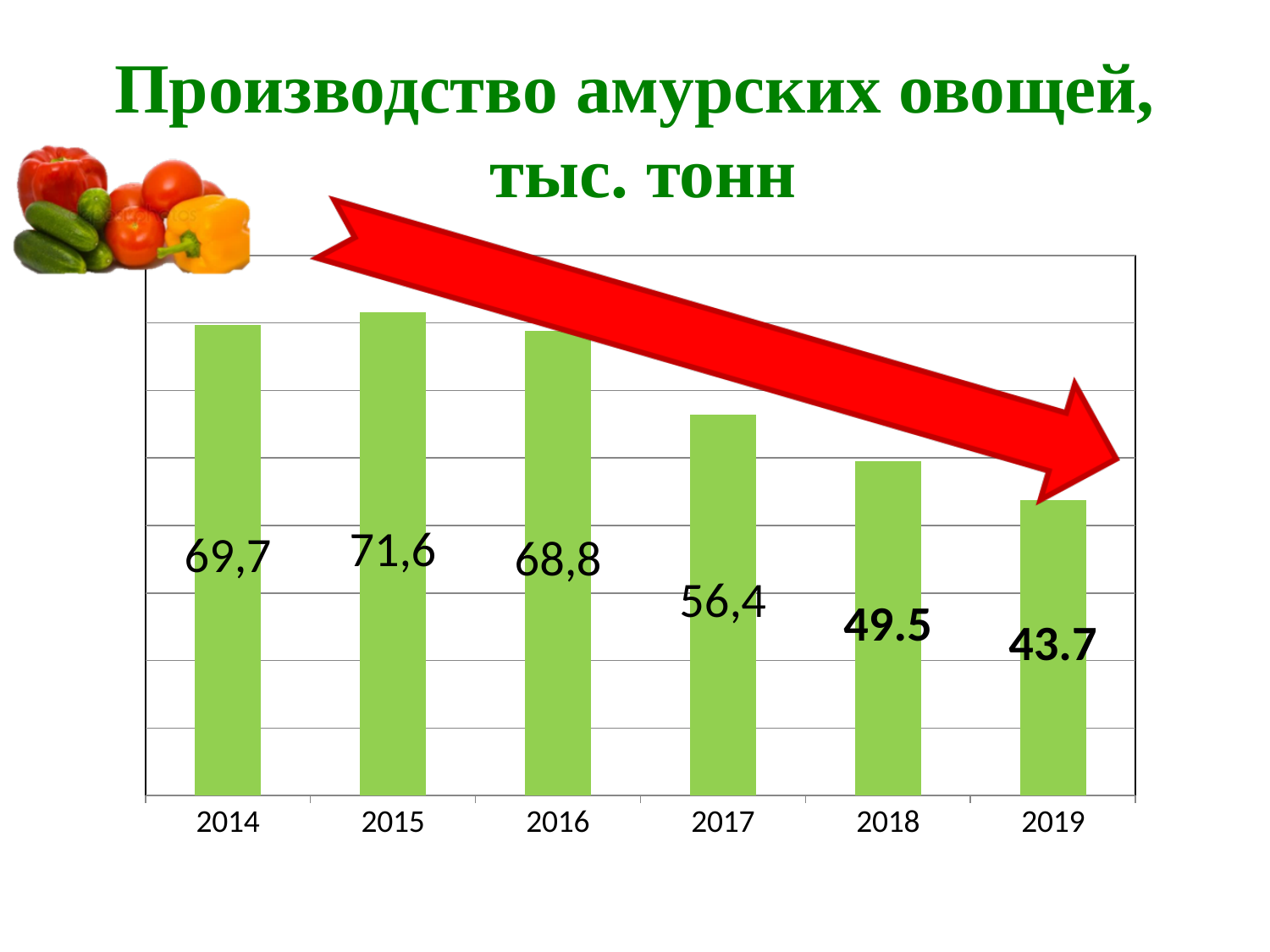
What is the difference between the values for 2018 and 2019? 5.8 Which year has the highest value? 2015 What is the value for 2017? 56,4 What is the value for 2014? 69,7 What is the value for 2019? 43.7 What is the title of the chart? Производство амурских овощей, тыс. тонн Do the values generally rise or fall from 2015 to 2019? fall How many years are shown on the x axis? 6 What is the difference between the values for 2015 and 2019? 27,9 Which is larger, the value for 2016 or the value for 2017? 2016 What kind of chart is shown on the slide? bar chart Which year has the lowest value? 2019